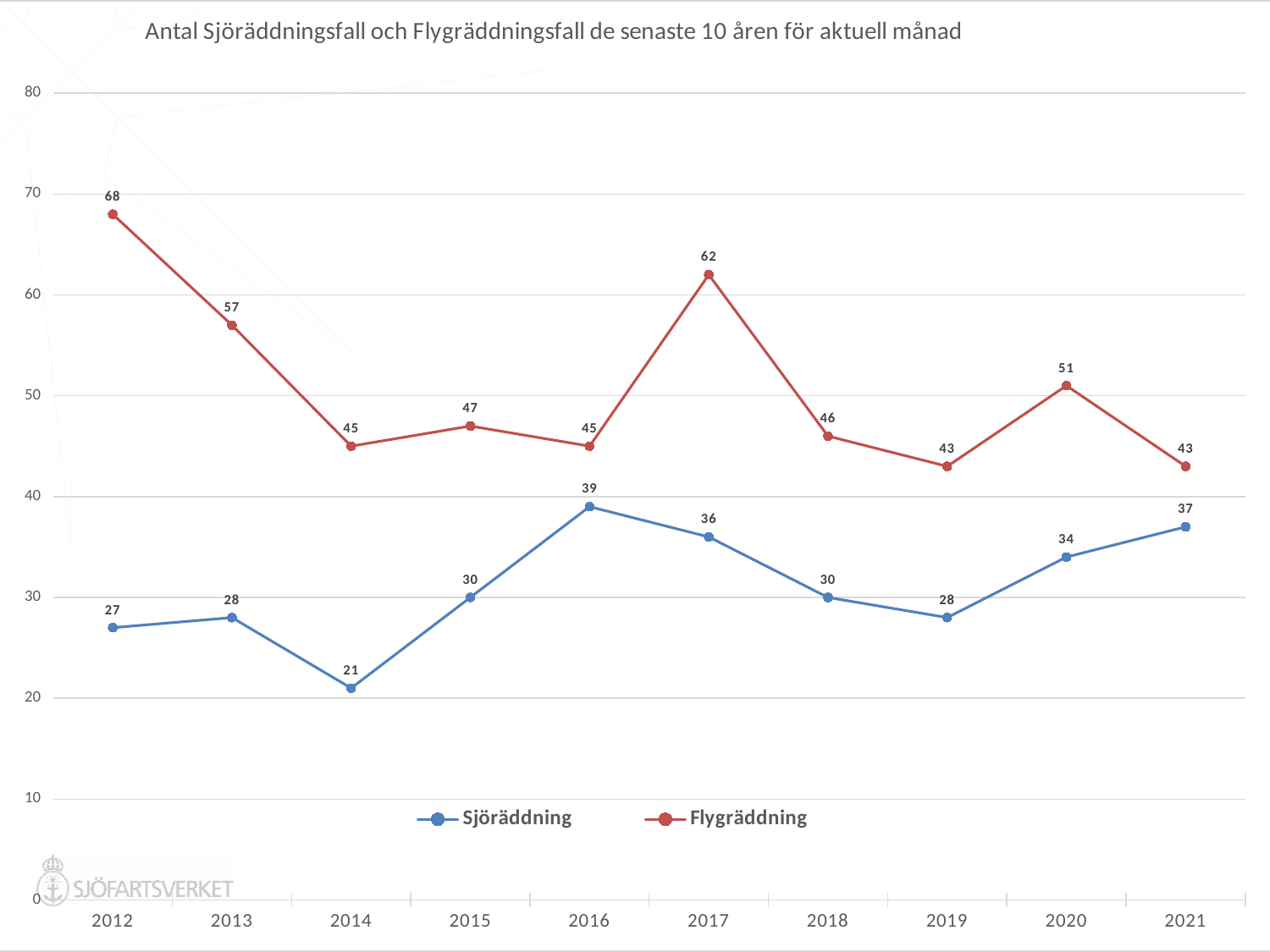
What is the value for Flygräddning in 2012? 68 How many years are shown on the x axis? 10 Does Flygräddning rise or fall from 2012 to 2014? fall Is the value for Flygräddning in 2013 greater or less than 50? greater How many series does the legend list? 2 What is the difference between Flygräddning and Sjöräddning in 2017? 26 In which year is Flygräddning lowest? 2019 and 2021 In which year is Sjöräddning highest? 2016 What kind of chart is shown on the slide? line chart What is the value for Sjöräddning in 2021? 37 Which is larger in 2020, Sjöräddning or Flygräddning? Flygräddning What is the value for Sjöräddning in 2014? 21